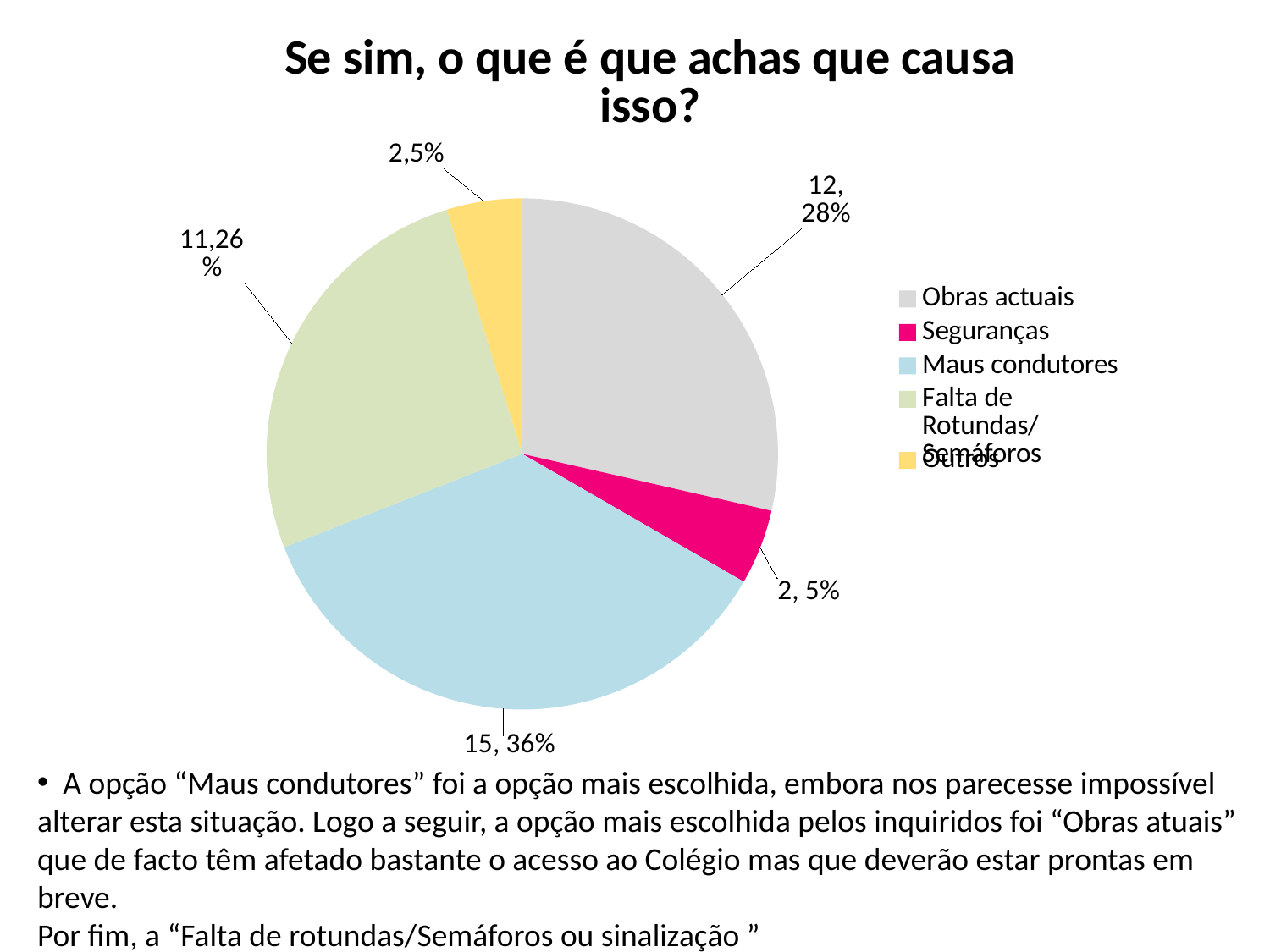
Which is larger, the slice for "Obras actuais" or the slice for "Falta de Rotundas/Semáforos"? Obras actuais What is the title of the chart? Se sim, o que é que achas que causa isso? What percentage of the pie does "Maus condutores" represent? 36% What is the count shown for "Seguranças"? 2 Which category has the largest slice of the pie? Maus condutores What is the difference between the counts for "Maus condutores" and "Obras actuais"? 3 What kind of chart is shown on the slide? Pie chart What percentage of the pie does "Falta de Rotundas/Semáforos" represent? 26% How many entries does the legend list? 5 How many slices does the pie chart have? 5 What colour is the slice for "Outros"? Yellow What is the count shown for "Obras actuais"? 12